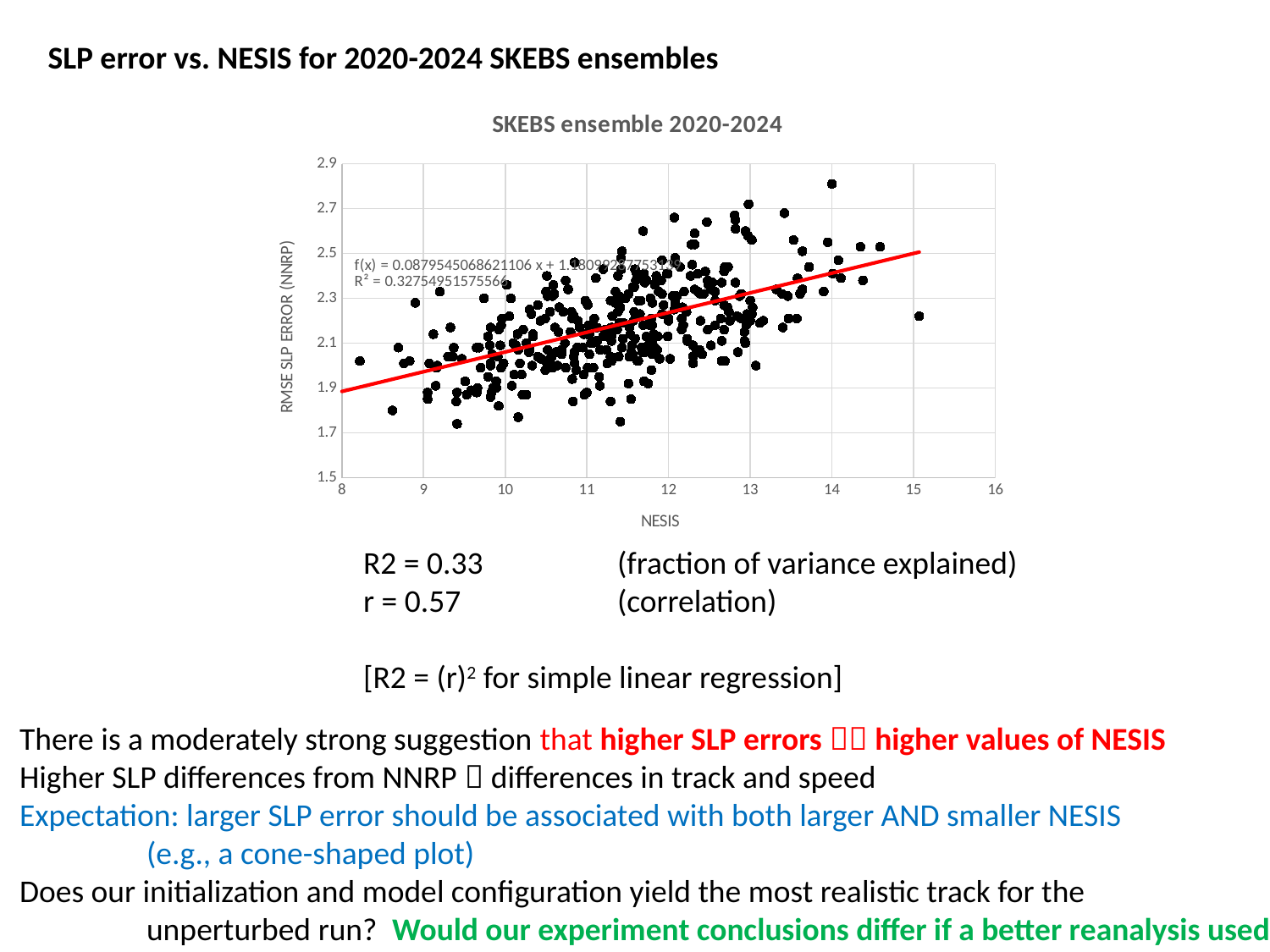
What is the slope (coefficient of x) in the trend line equation printed on the chart? 0.0879545068621106 Is the RMSE SLP error of the rightmost point on the chart (near NESIS 15) greater or less than 2.5? less What is the maximum value shown on the y axis of the chart? 2.9 Is the RMSE SLP error of the lowest point on the chart (near NESIS 11.5) greater or less than 1.9? less Do the RMSE SLP error values tend to rise or fall as NESIS increases along the x axis? Rise Is the RMSE SLP error of the highest point on the chart (near NESIS 14) greater or less than 2.7? greater What is the title of the chart? SKEBS ensemble 2020-2024 What R² value is printed on the chart for the fitted line? 0.32754951575566 According to the text below the chart, what is the correlation r? 0.57 What kind of chart is shown on the slide? Scatter plot What is the maximum value shown on the x axis of the chart? 16 What is the label of the x axis of the chart? NESIS